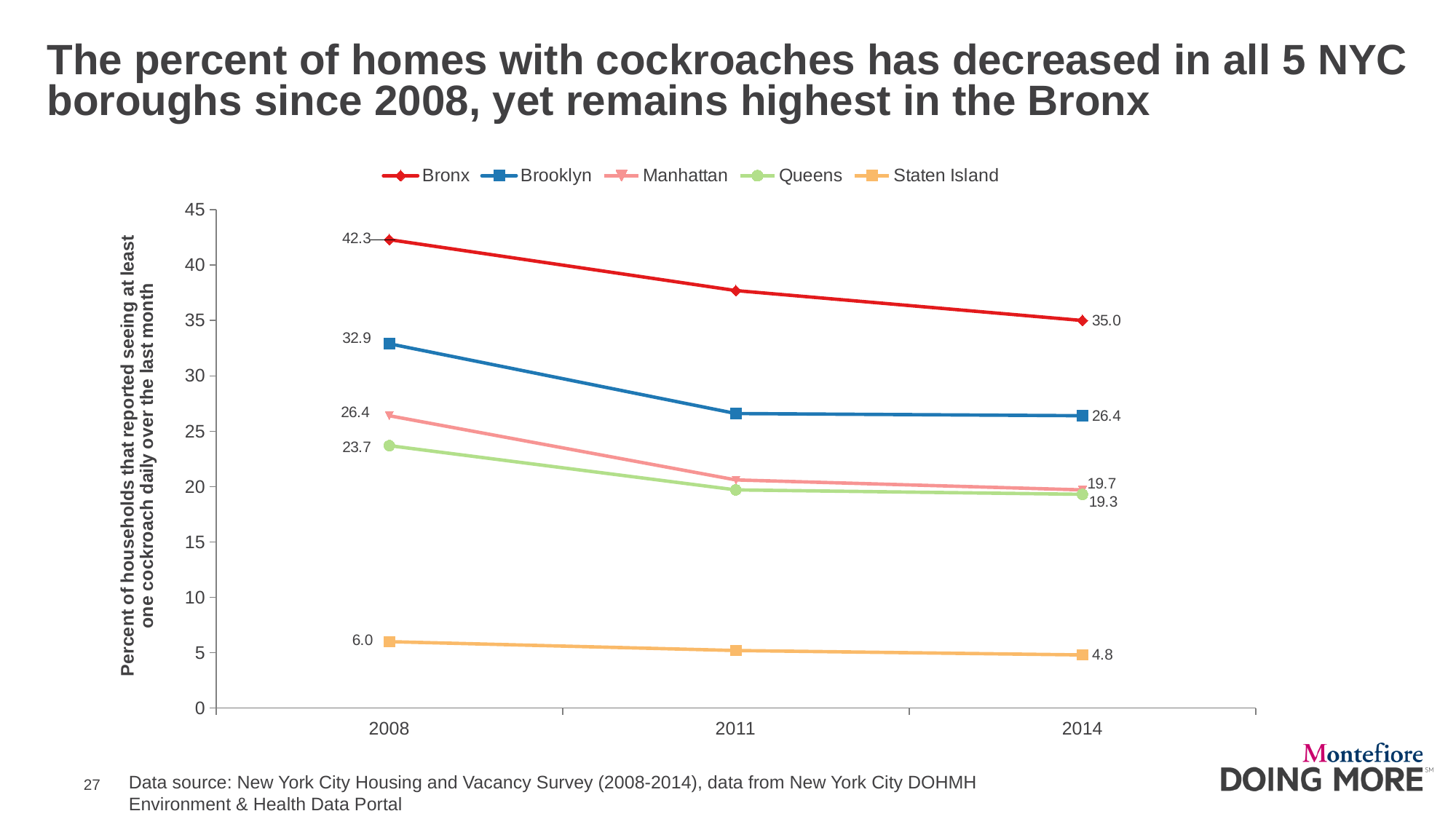
Which borough had the highest value in 2014? Bronx By how much did the Bronx value decrease from 2008 to 2014? 7.3 What kind of chart is shown on the slide? Line chart What is the difference between Brooklyn's 2008 and 2014 values? 6.5 Is the value for Brooklyn in 2011 greater or less than 30? less What was the value for Queens in 2008? 23.7 Is the value for the Bronx in 2011 greater or less than 35? greater What was the percent of households in the Bronx reporting cockroaches in 2008? 42.3 In 2008, which was higher: Manhattan or Queens? Manhattan How many series does the legend list? 5 What was the value for Staten Island in 2014? 4.8 Which borough had the lowest value in 2008? Staten Island